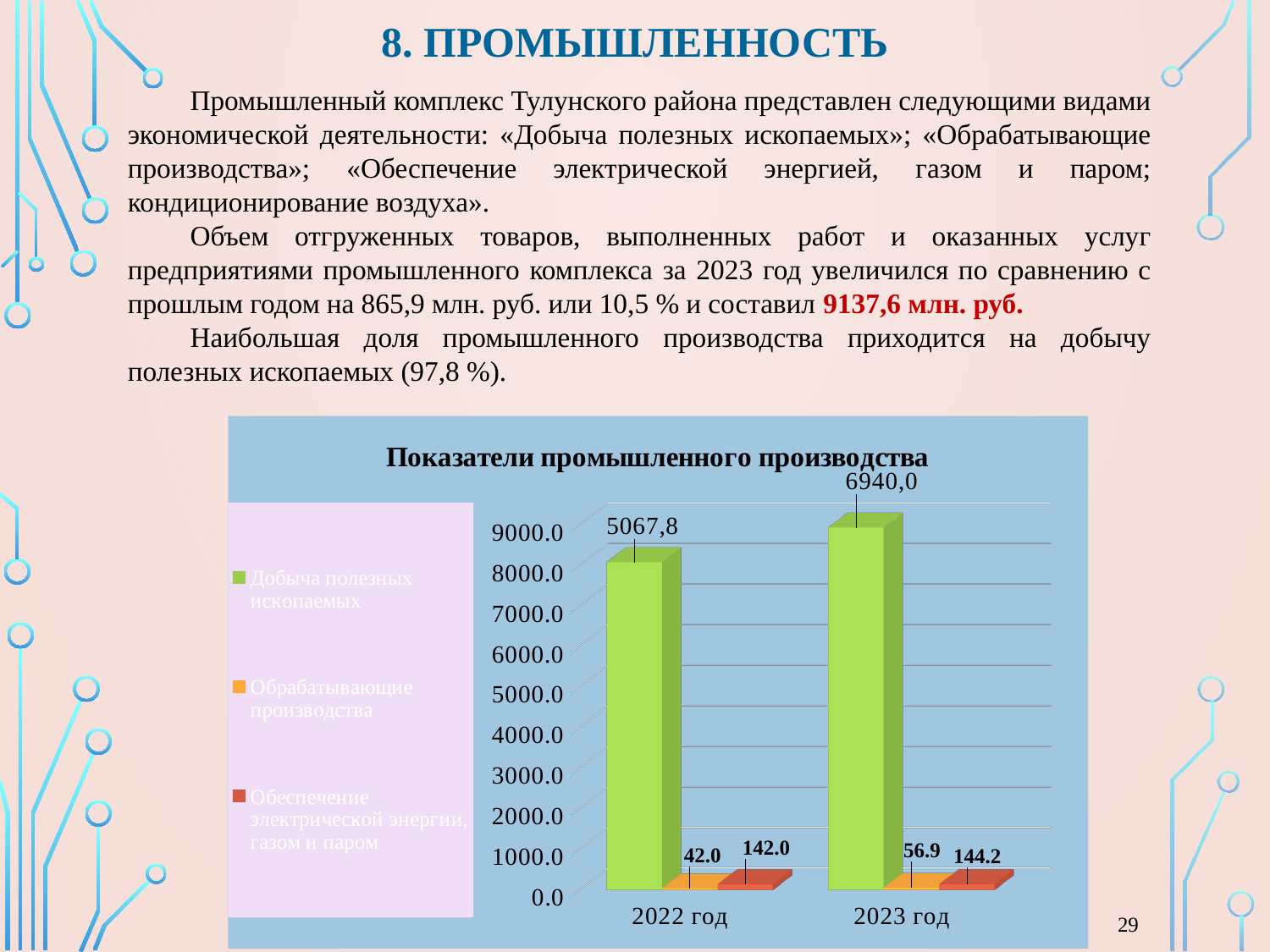
What is the value for Добыча полезных ископаемых in 2023 год? 6940,0 What is the title of the chart? Показатели промышленного производства Which series has the highest value in 2023 год? Добыча полезных ископаемых Which series has the lowest value in 2022 год? Обрабатывающие производства What is the value for Добыча полезных ископаемых in 2022 год? 5067,8 What is the value for Обрабатывающие производства in 2023 год? 56.9 Did the value for Добыча полезных ископаемых rise or fall from 2022 год to 2023 год? rise How many series does the chart legend list? 3 How many year categories are shown on the x axis of the chart? 2 What is the value for Обрабатывающие производства in 2022 год? 42.0 What type of chart is shown on the slide? bar chart What is the value for Обеспечение электрической энергии, газом и паром in 2023 год? 144.2